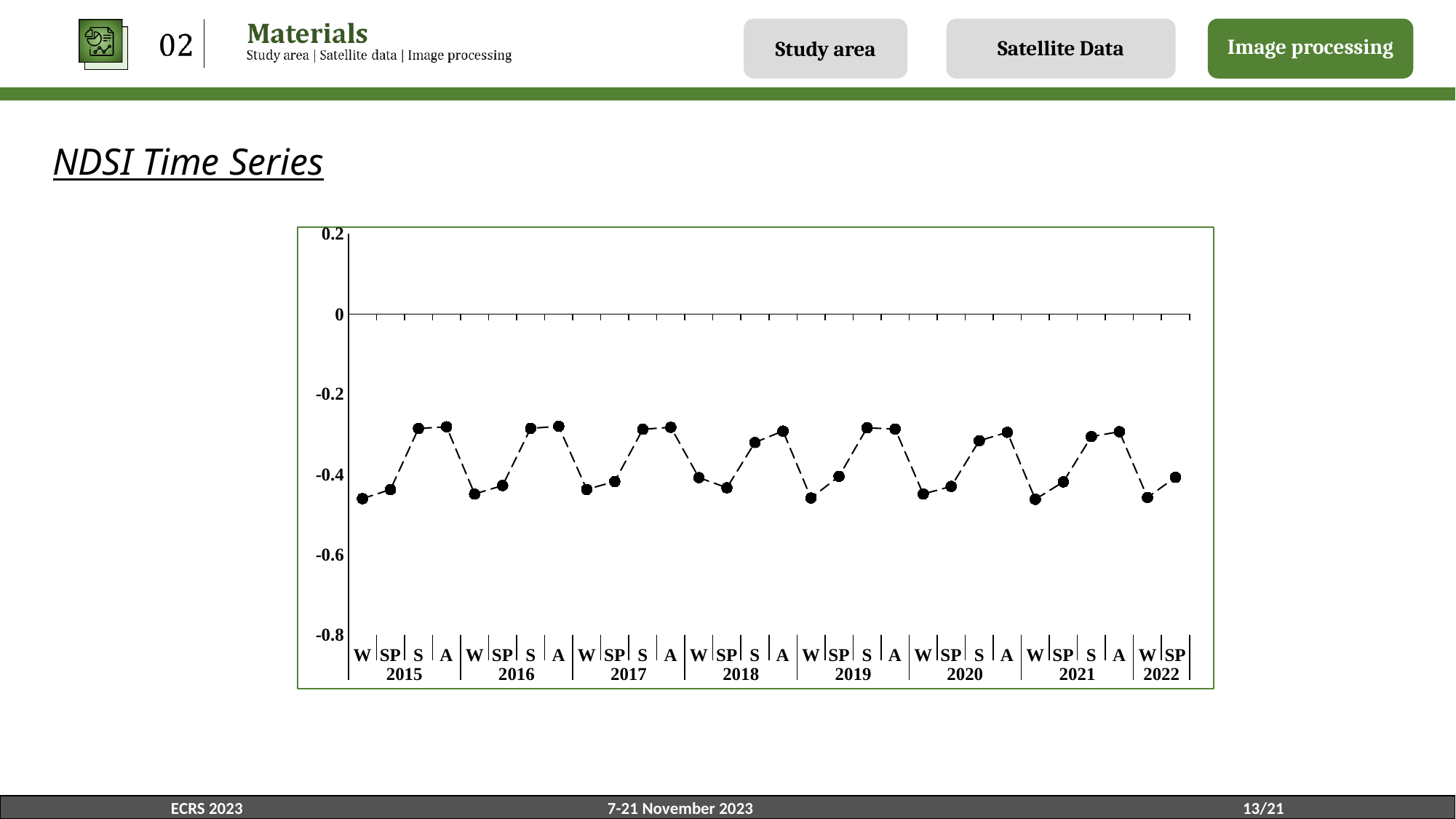
Is the value for A 2020 greater or less than -0.4? greater What kind of chart is shown on the slide? line chart Is the value for W 2019 greater or less than -0.4? less How many year labels appear along the x axis of the chart? 8 What is the lowest value shown on the y axis? -0.8 How many data points are plotted on the chart? 30 Within 2018, do the values rise or fall from W to S? rise What is the title of the chart on the slide? NDSI Time Series Is the value for S 2015 greater or less than -0.4? greater Which is larger, the value for W 2017 or the value for S 2017? S 2017